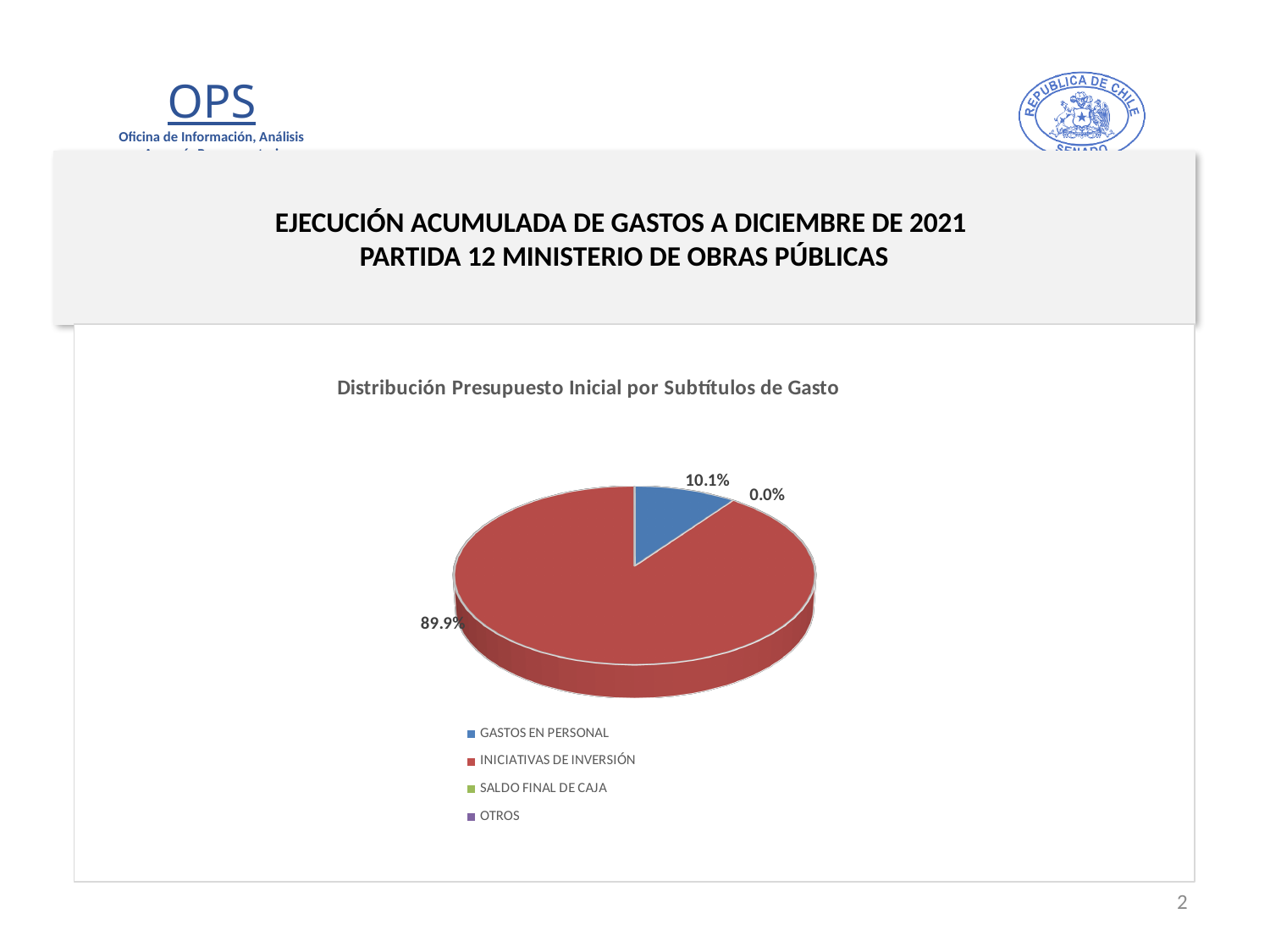
What share of the pie does INICIATIVAS DE INVERSIÓN represent? 89.9% What colour is the slice for INICIATIVAS DE INVERSIÓN? Red What is the combined share of GASTOS EN PERSONAL and INICIATIVAS DE INVERSIÓN? 100.0% What is the title of the chart? Distribución Presupuesto Inicial por Subtítulos de Gasto Which is larger, the slice for GASTOS EN PERSONAL or the slice for INICIATIVAS DE INVERSIÓN? INICIATIVAS DE INVERSIÓN By how many percentage points does INICIATIVAS DE INVERSIÓN exceed GASTOS EN PERSONAL? 79.8 percentage points How many categories does the legend list? 4 What kind of chart is shown on the slide? Pie chart Which category has the largest slice of the pie? INICIATIVAS DE INVERSIÓN What share of the pie does GASTOS EN PERSONAL represent? 10.1%